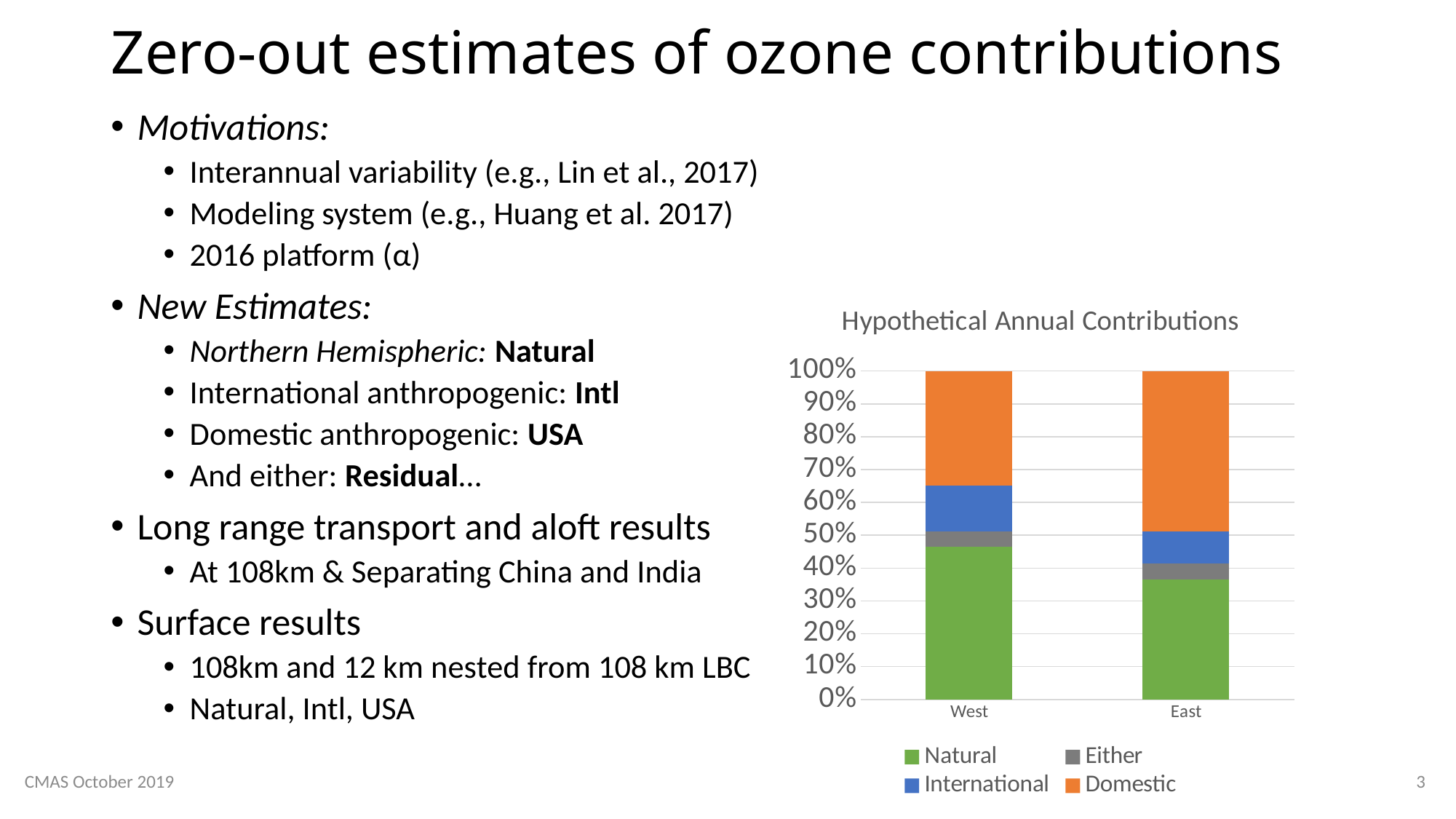
Is the Natural value for West greater or less than 40%? greater Which category has the larger Natural share, West or East? West Is the Natural value for East greater or less than 40%? less What is the total of the stacked bar for West? 100% Which category has the larger Domestic share, West or East? East Which colour represents the Domestic series in the chart? orange What is the title of the chart? Hypothetical Annual Contributions How many series does the chart legend list? 4 What kind of chart is shown on the slide? bar chart Which category has the larger International share, West or East? West Is the International value for West greater or less than 20%? less How many categories are shown on the x axis of the chart? 2